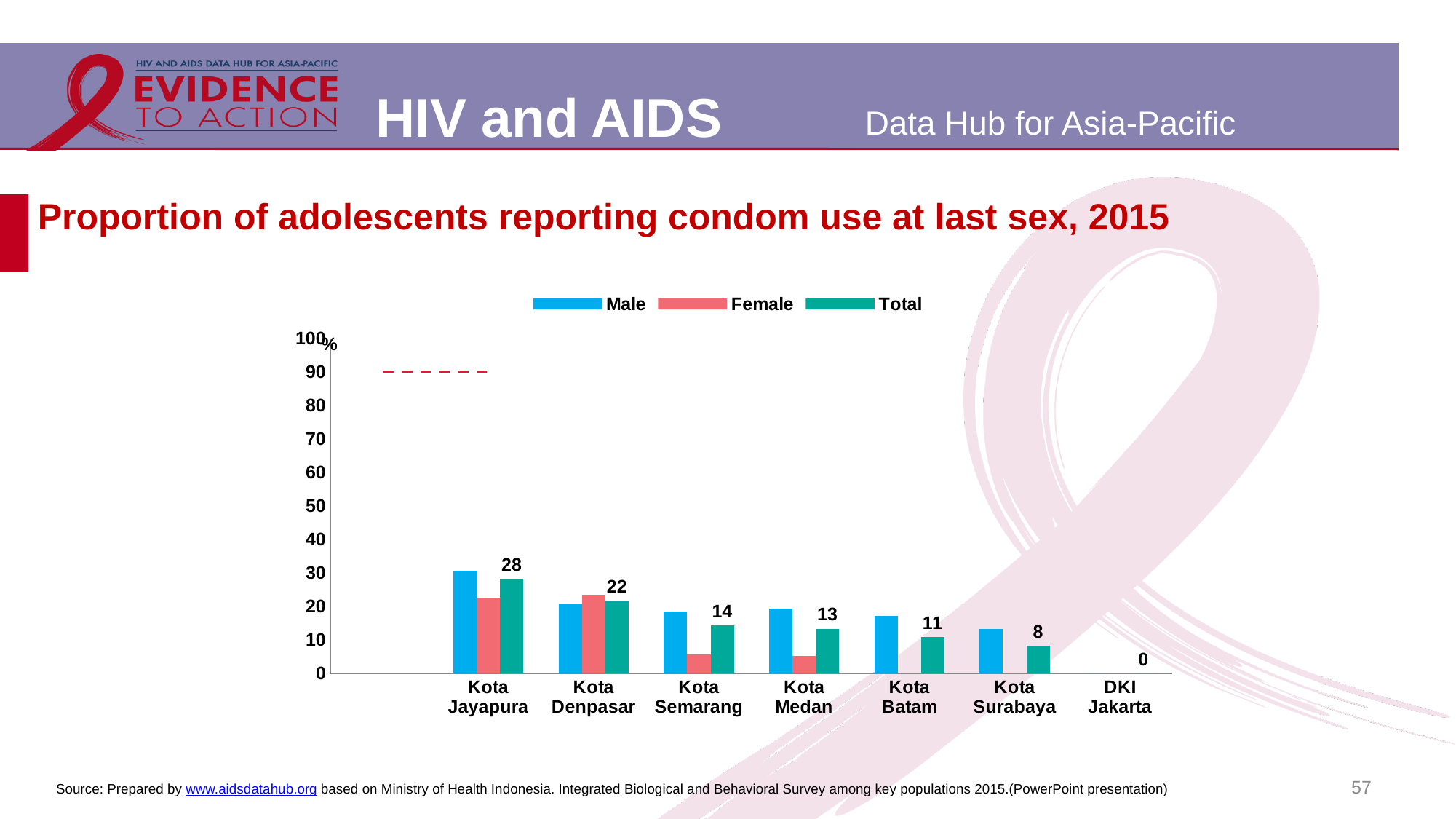
Which has a larger Total value, Kota Denpasar or Kota Medan? Kota Denpasar Which city has the lowest Total value? DKI Jakarta What is the Total value for Kota Jayapura? 28 Is the Male value for Kota Jayapura greater or less than 20? greater What is the Total value for Kota Surabaya? 8 What is the difference between the Total values for Kota Jayapura and Kota Surabaya? 20 What is the Total value for DKI Jakarta? 0 How many series does the legend list? 3 Do the Total values rise or fall from left to right across the cities? fall Which city has the highest Total value? Kota Jayapura How many cities are shown on the x axis? 7 Is the Female value for Kota Semarang greater or less than 10? less